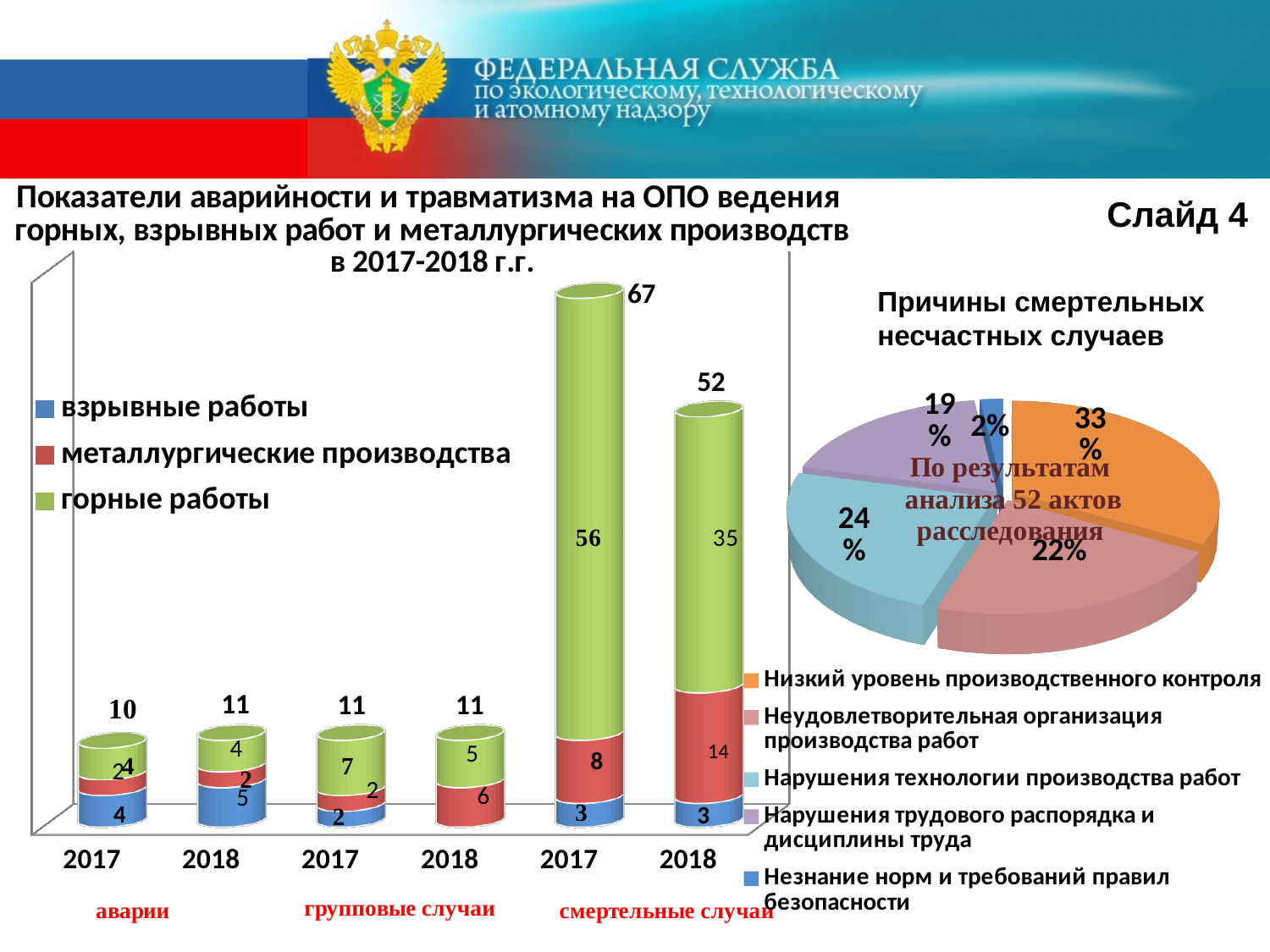
In the bar chart, what is the value for горные работы in the смертельные случаи 2018 bar? 35 In the bar chart, what is the total for смертельные случаи in 2017? 67 In the pie chart 'Причины смертельных несчастных случаев', what share is Низкий уровень производственного контроля? 33% In the bar chart, is the value for горные работы in смертельные случаи larger in 2017 or 2018? 2017 In the bar chart, what is the difference between the totals for смертельные случаи in 2017 and 2018? 15 In the bar chart, what is the value for металлургические производства in the смертельные случаи 2018 bar? 14 In the pie chart 'Причины смертельных несчастных случаев', which cause has the smallest share? Незнание норм и требований правил безопасности In the pie chart 'Причины смертельных несчастных случаев', what share is Нарушения технологии производства работ? 24% What kind of chart is the chart titled 'Причины смертельных несчастных случаев'? pie chart In the bar chart, which bar has the highest total? смертельные случаи 2017 In the bar chart, what is the value for взрывные работы in the аварии 2017 bar? 4 In the bar chart, how many series does the legend list? 3